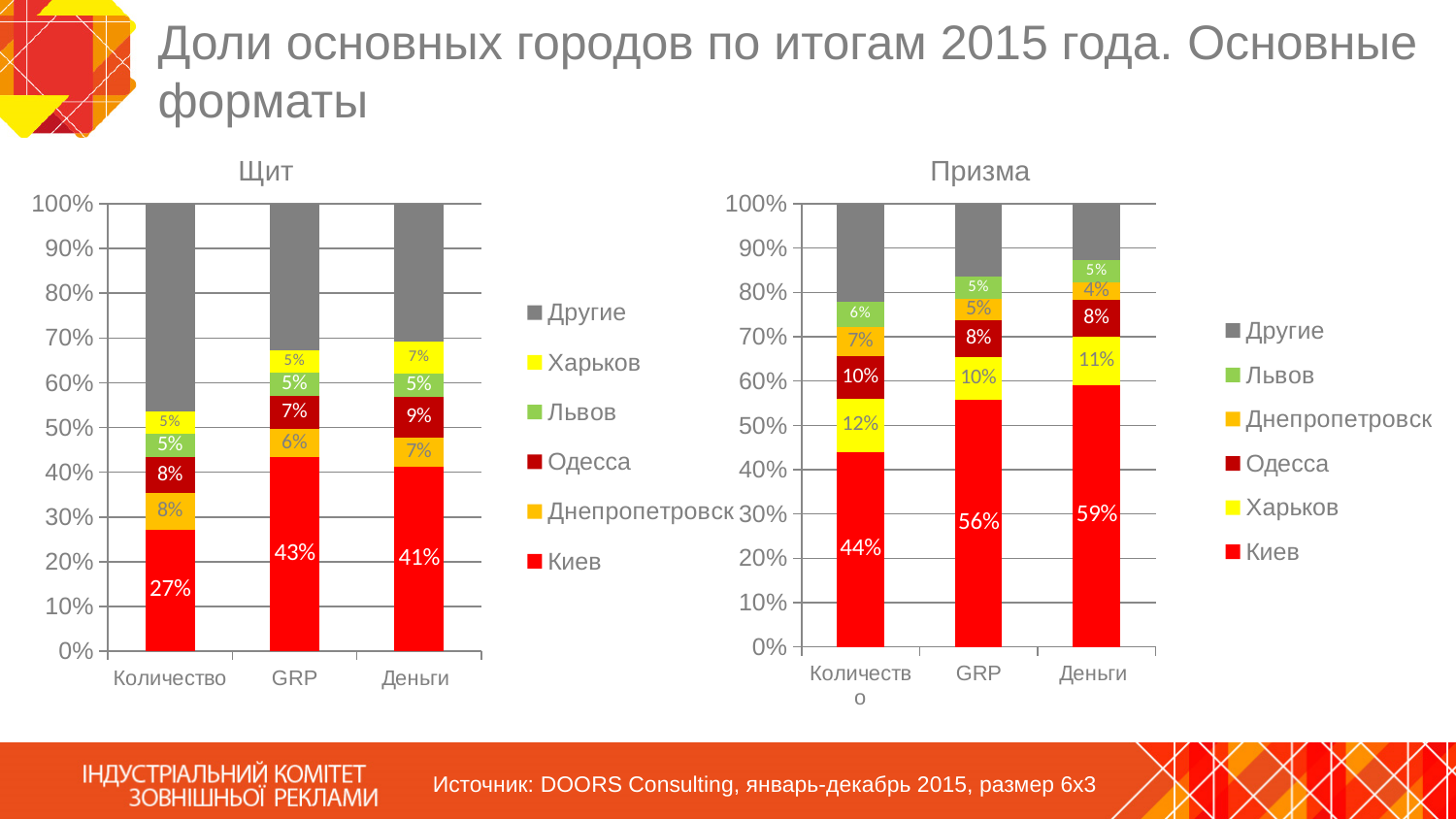
In the Щит chart, what is the value for Киев in the Количество category? 27% In the Щит chart, which category has the lowest value for Киев? Количество In the Щит chart, what is the difference between the Киев values for GRP and Количество? 16% What kind of chart is the Щит chart? Stacked bar chart In the Щит chart, what is the value for Одесса in the Деньги category? 9% In the Призма chart, is the value for Киев in the Деньги category greater or less than 50%? greater In the Призма chart, which is larger: the Одесса value for Количество or the Одесса value for GRP? Количество In the Призма chart, what is the value for Киев in the GRP category? 56% In the Призма chart, what is the value for Харьков in the Количество category? 12% In the Призма chart, which category has the highest value for Киев? Деньги How many series does the legend of the Призма chart list? 6 How many categories are shown on the x axis of the Щит chart? 3